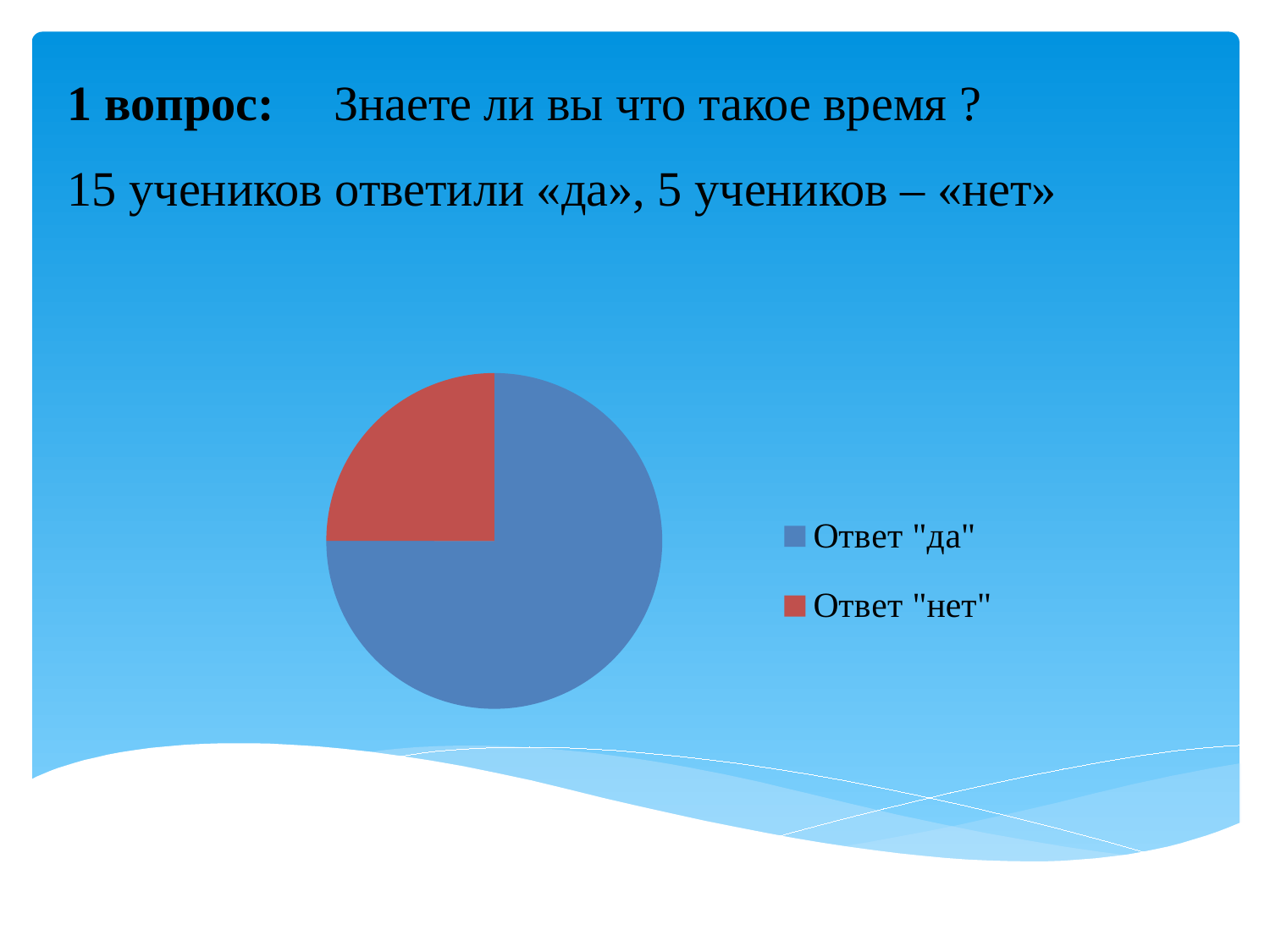
How many slices does the pie chart have? 2 Which slice of the pie chart is the largest? Ответ "да" What kind of chart is shown on the slide? pie chart Which is larger: the number of students who answered "да" or the number who answered "нет"? Ответ "да" How many students answered "нет" according to the slide? 5 What share of the pie does the "Ответ "да"" slice represent? 75% What colour is the "Ответ "нет"" slice in the pie chart? red How many students answered "да" according to the slide? 15 Which slice of the pie chart is the smallest? Ответ "нет" How many entries does the legend of the pie chart list? 2 What share of the pie does the "Ответ "нет"" slice represent? 25% What is the difference between the number of students who answered "да" and those who answered "нет"? 10